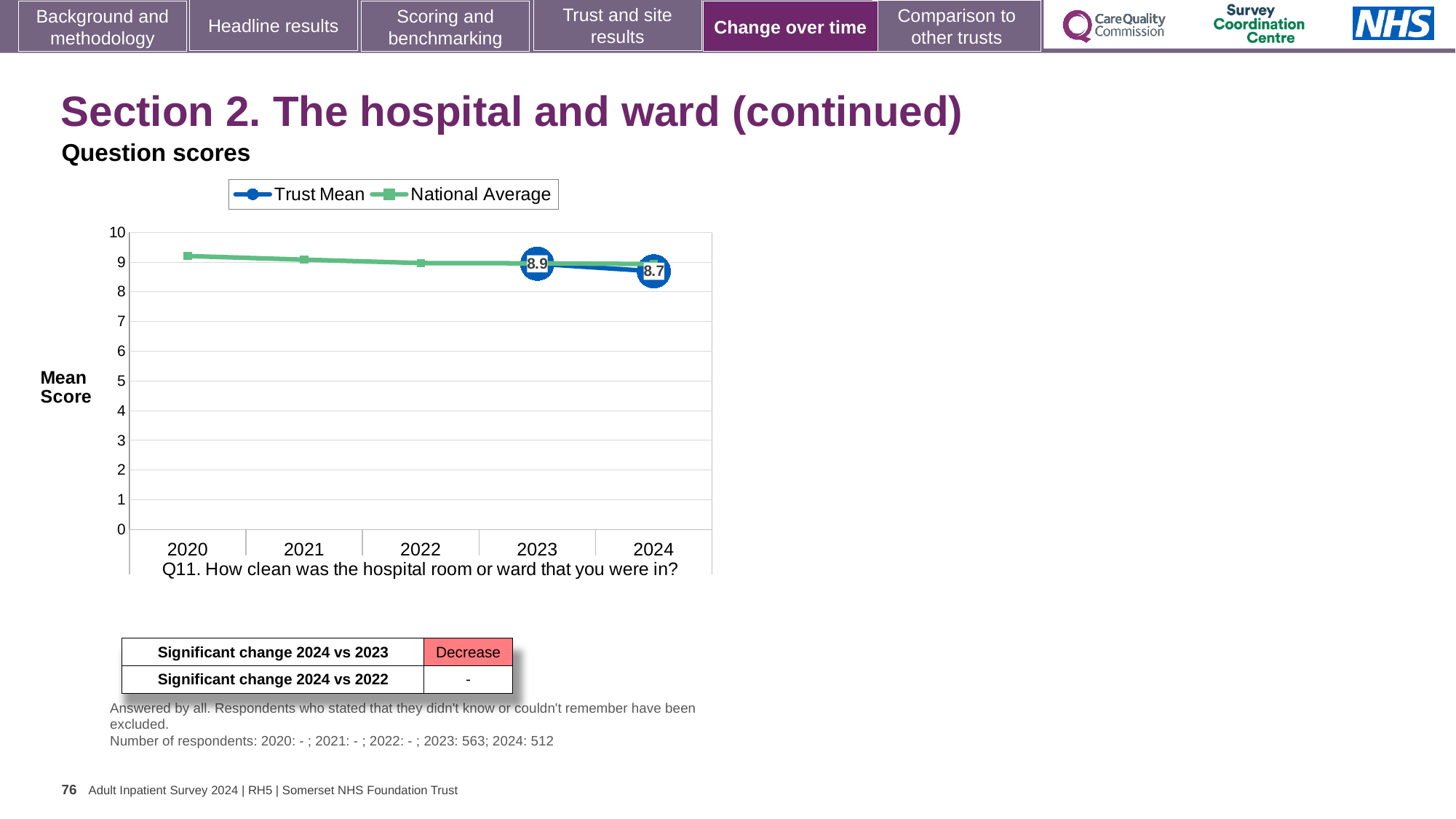
Does the Trust Mean rise or fall from 2023 to 2024? fall What are the two series named in the legend? Trust Mean and National Average Is the National Average value for 2020 greater or less than 9? greater How many series does the legend list? 2 What is the Trust Mean value for 2024? 8.7 In which year is the Trust Mean highest among the years where it is plotted? 2023 What kind of chart is shown on the slide? line chart How many years are shown on the x axis? 5 What is the Trust Mean value for 2023? 8.9 Which year has the higher Trust Mean, 2023 or 2024? 2023 What is the label on the y axis of the chart? Mean Score By how much did the Trust Mean change between 2023 and 2024? 0.2